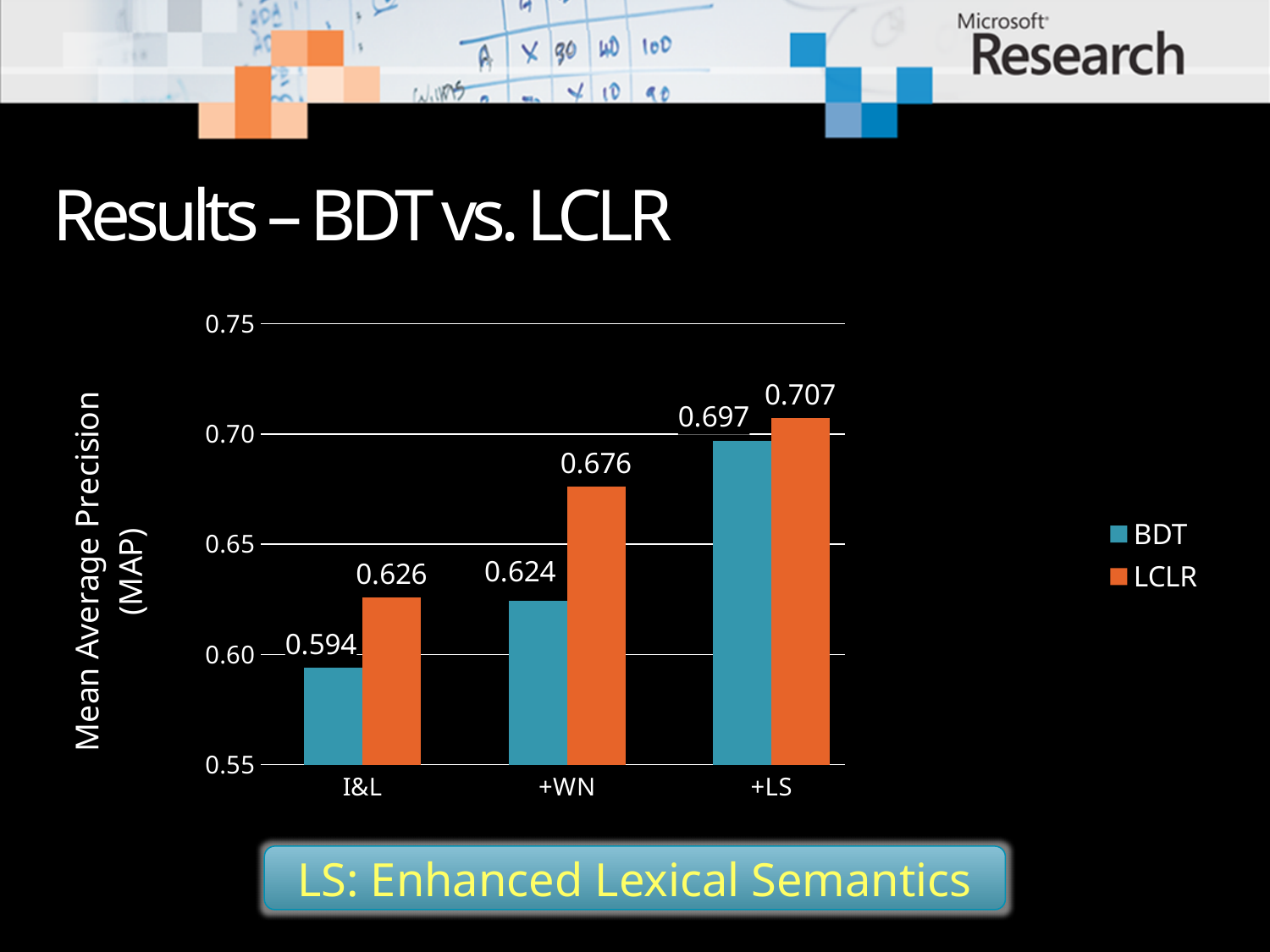
What is the difference between the BDT values for +LS and I&L? 0.103 Which is larger on the I&L category, the BDT value or the LCLR value? LCLR Do the BDT values rise or fall from I&L to +LS? rise How many categories are shown on the x axis? 3 Which category has the highest LCLR value? +LS What is the MAP value for LCLR on the +LS category? 0.707 What is the difference between the LCLR and BDT values on the +WN category? 0.052 Which category has the lowest BDT value? I&L What is the MAP value for LCLR on the +WN category? 0.676 How many series does the legend list? 2 What is the MAP value for BDT on the I&L category? 0.594 What kind of chart is shown on the slide? bar chart